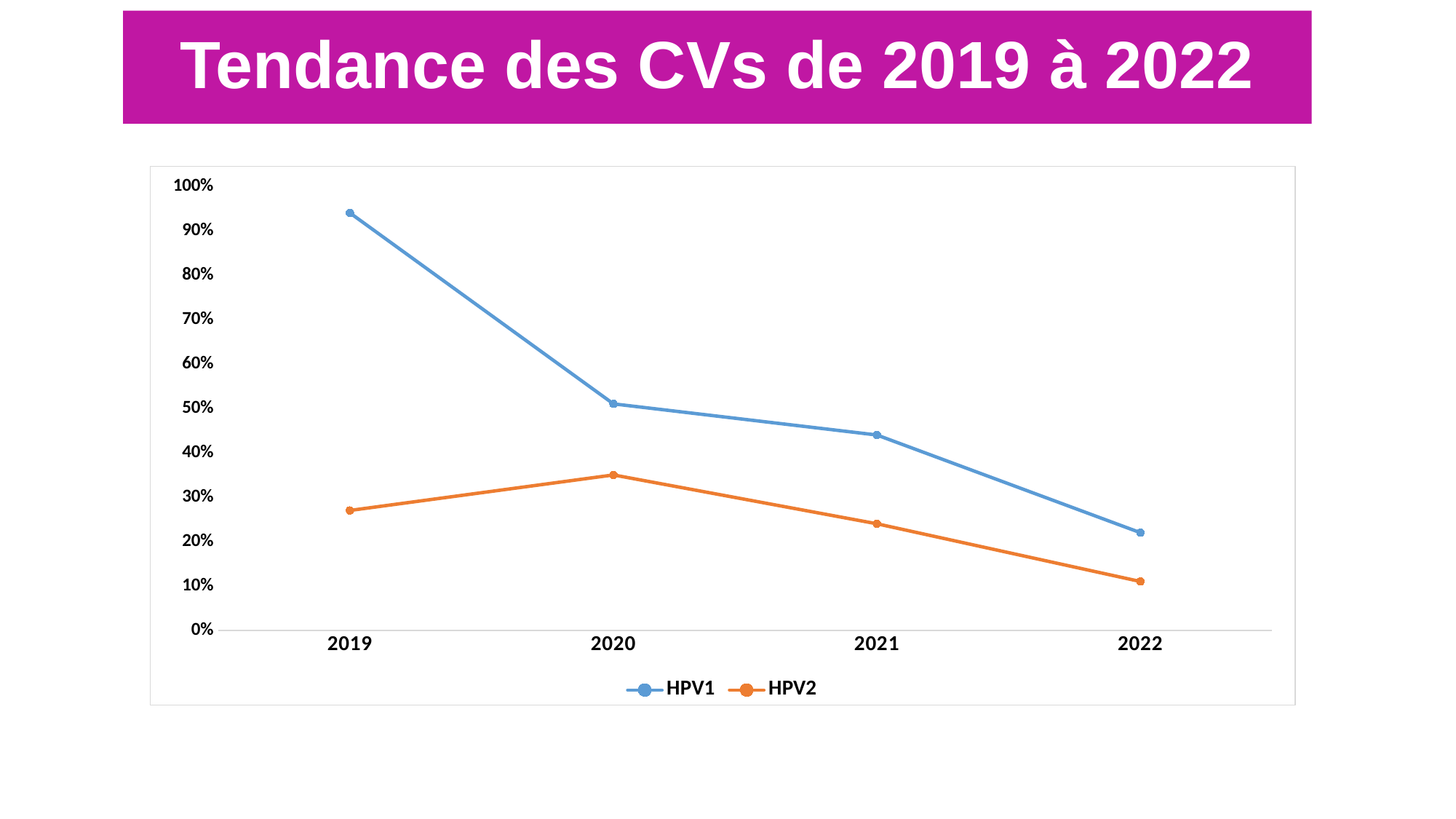
In which year is the HPV2 value highest? 2020 In which year is the HPV1 value lowest? 2022 Is the HPV2 value for 2019 greater or less than 30%? less What kind of chart is shown on the slide? line chart Which series is drawn in orange? HPV2 In which year is the HPV2 value lowest? 2022 In which year is the HPV1 value highest? 2019 How many series does the legend list? 2 Does the HPV1 value rise or fall from 2019 to 2022? fall Is the HPV1 value for 2019 greater or less than 90%? greater What is the title of the slide? Tendance des CVs de 2019 à 2022 How many years are plotted on the x axis? 4